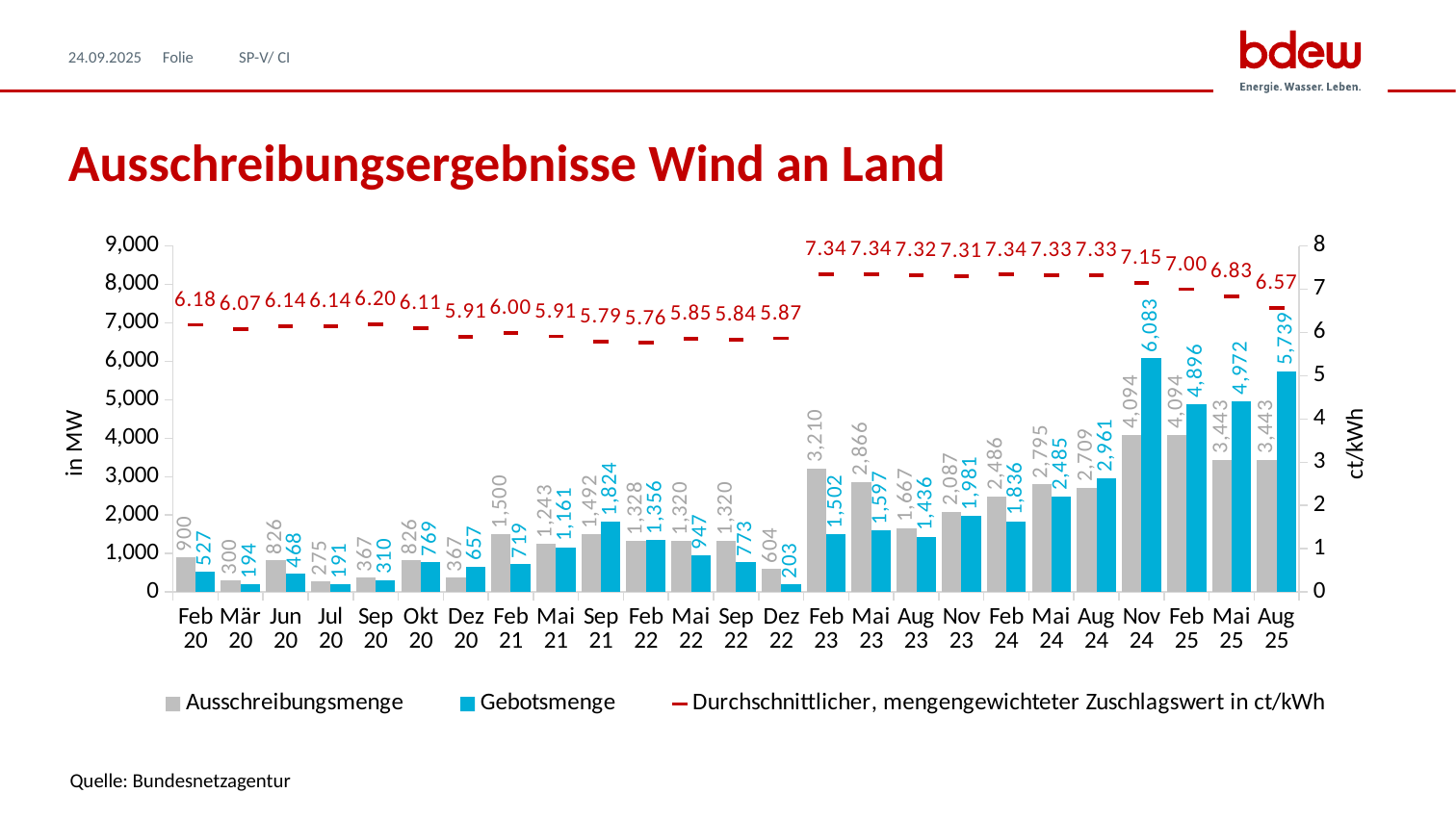
In which period is the Gebotsmenge highest? Nov 24 By how much does the Gebotsmenge exceed the Ausschreibungsmenge in Nov 24? 1,989 In Sep 21, which is larger: the Ausschreibungsmenge or the Gebotsmenge? Gebotsmenge How many series does the legend list? 3 What is the Gebotsmenge for Nov 24? 6,083 What is the Durchschnittlicher, mengengewichteter Zuschlagswert for Aug 25? 6.57 What is the Ausschreibungsmenge for Feb 23? 3,210 Does the Durchschnittlicher, mengengewichteter Zuschlagswert rise or fall from Nov 24 to Aug 25? fall How many periods are shown on the x axis? 25 Is the Ausschreibungsmenge for Feb 25 greater or less than 4,000? greater In which period is the Durchschnittlicher, mengengewichteter Zuschlagswert lowest? Feb 22 What kind of chart is used for the Ausschreibungsmenge and Gebotsmenge? bar chart